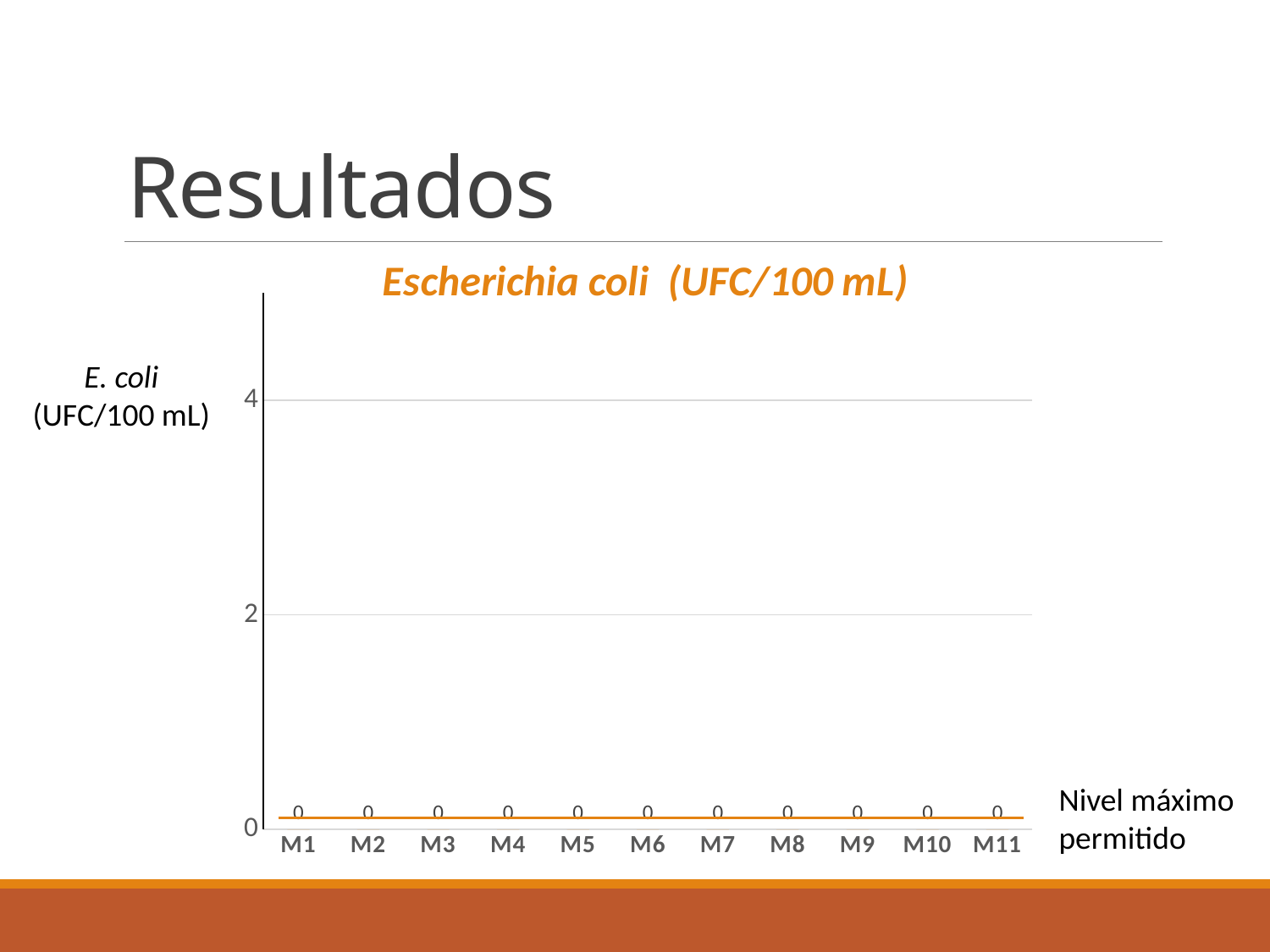
What does the orange horizontal line at 0 represent? Nivel máximo permitido Is the value for M10 greater or less than 4? less What is the value for M1? 0 Is the value for M7 greater or less than 2? less What is the highest value shown on the y axis? 4 What is the title of the chart? Escherichia coli (UFC/100 mL) What is the value for M5? 0 What is the value for M11? 0 How many categories are shown on the x axis? 11 What is the difference between the values for M3 and M8? 0 Do the values rise, fall, or stay constant from M1 to M11? stay constant